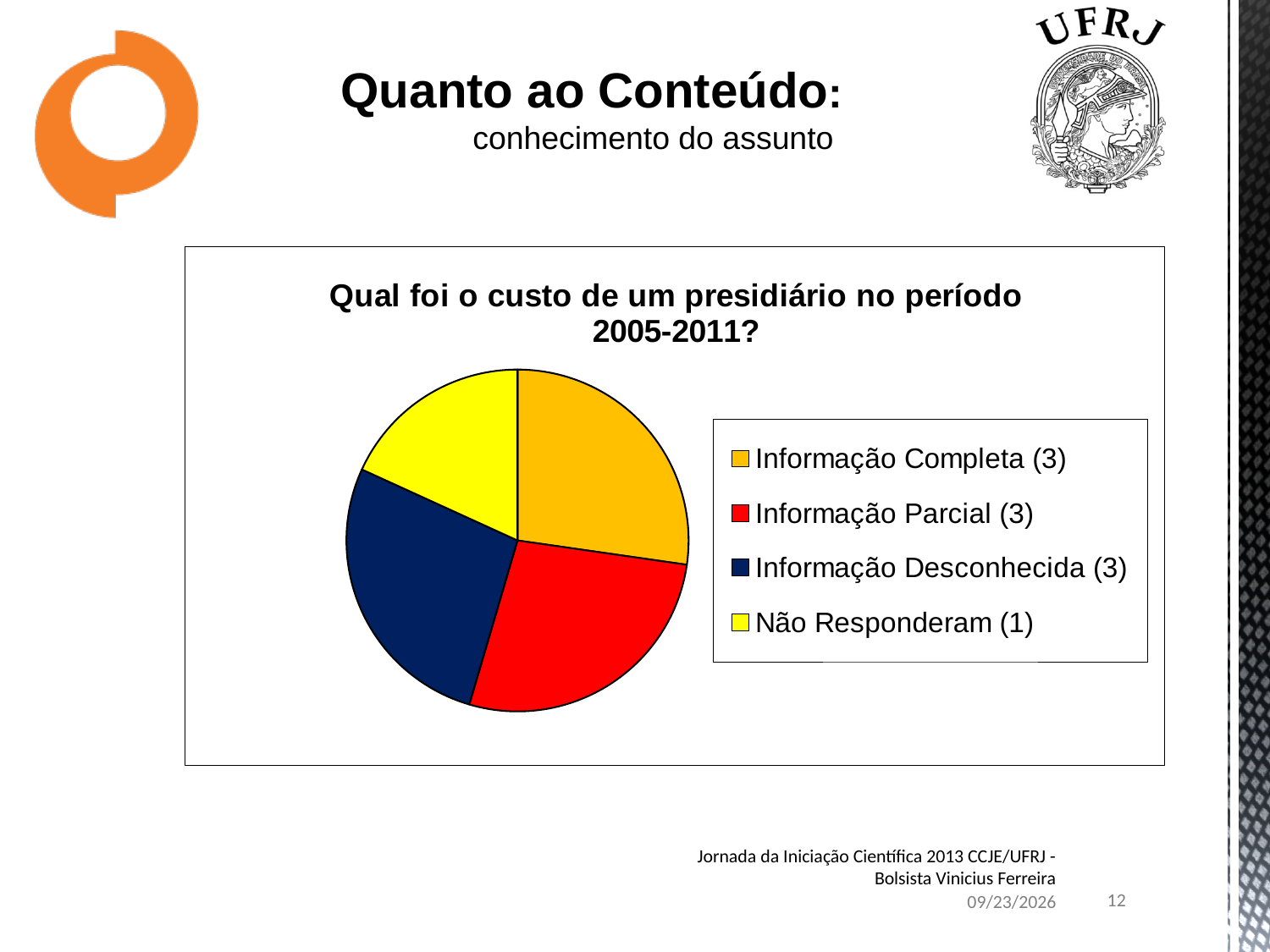
What is the total of all the values in the pie chart? 10 Which category has the smallest slice of the pie? Não Responderam What is the difference between the values for Informação Completa and Não Responderam? 2 What is the value shown for Informação Desconhecida? 3 How many slices does the pie chart have? 4 Which is larger, Informação Parcial or Não Responderam? Informação Parcial What is the value shown for Informação Completa? 3 What kind of chart is shown on the slide? pie chart What colour is the slice for Informação Desconhecida? dark blue What is the value shown for Não Responderam? 1